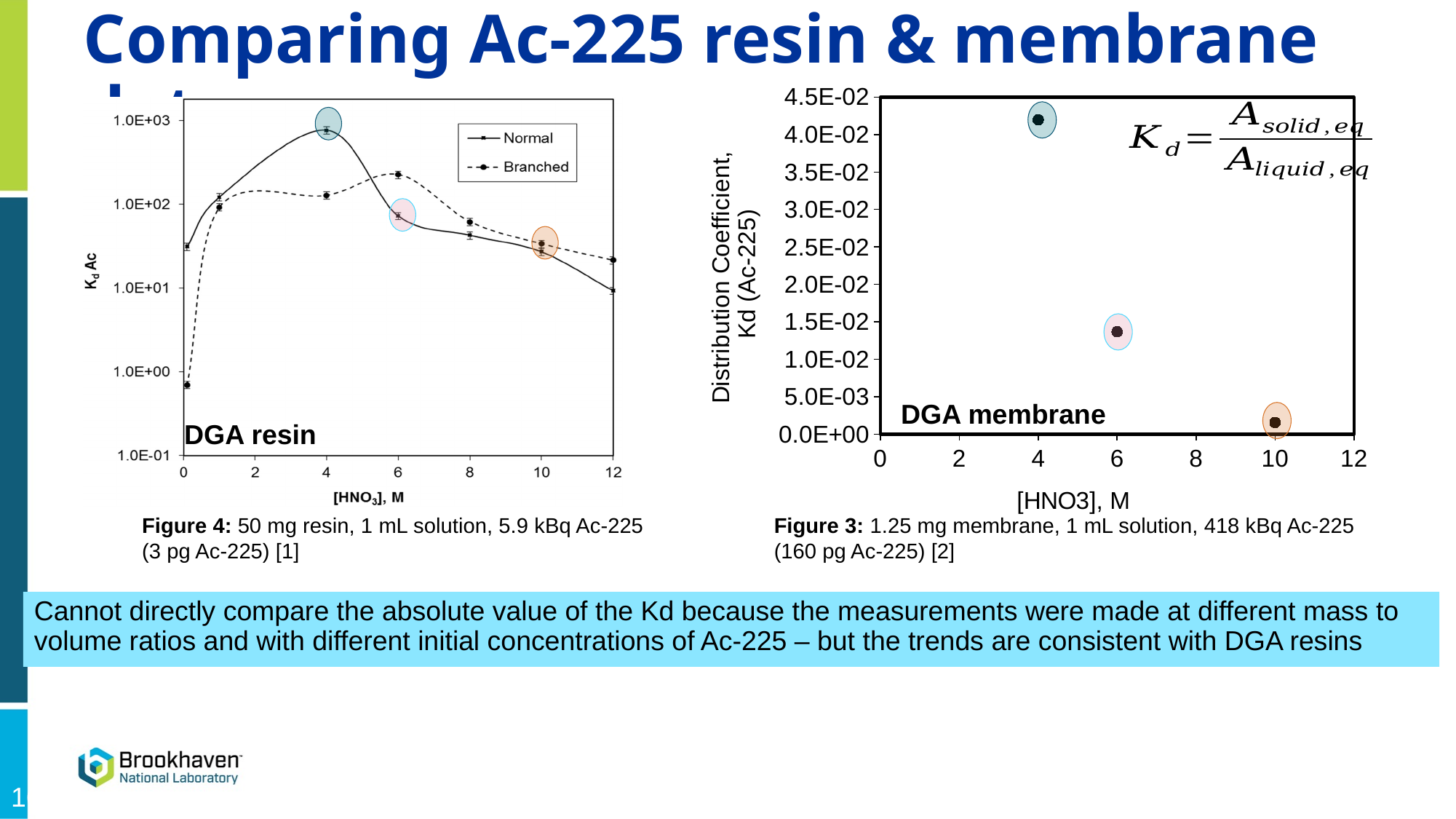
On the DGA membrane chart, at which [HNO3] concentration is the distribution coefficient lowest? 10 M On the DGA membrane chart, is the value at 10 M greater or less than 5.0E-03? less On the DGA membrane chart, is the value at 4 M greater or less than 4.0E-02? greater What are the two series named in the legend of the DGA resin chart? Normal and Branched How many data points are plotted on the DGA membrane chart? 3 What kind of chart is the DGA resin chart on the left? line chart On the DGA resin chart, which series has the larger Kd at 6 M [HNO3], Normal or Branched? Branched On the DGA membrane chart, do the values rise or fall as [HNO3] increases from 4 M to 10 M? fall On the DGA membrane chart, at which [HNO3] concentration is the distribution coefficient highest? 4 M What kind of chart is the DGA membrane chart on the right? scatter chart On the DGA resin chart, is the Normal series value at 4 M greater or less than 1.0E+02? greater How many series does the legend of the DGA resin chart list? 2